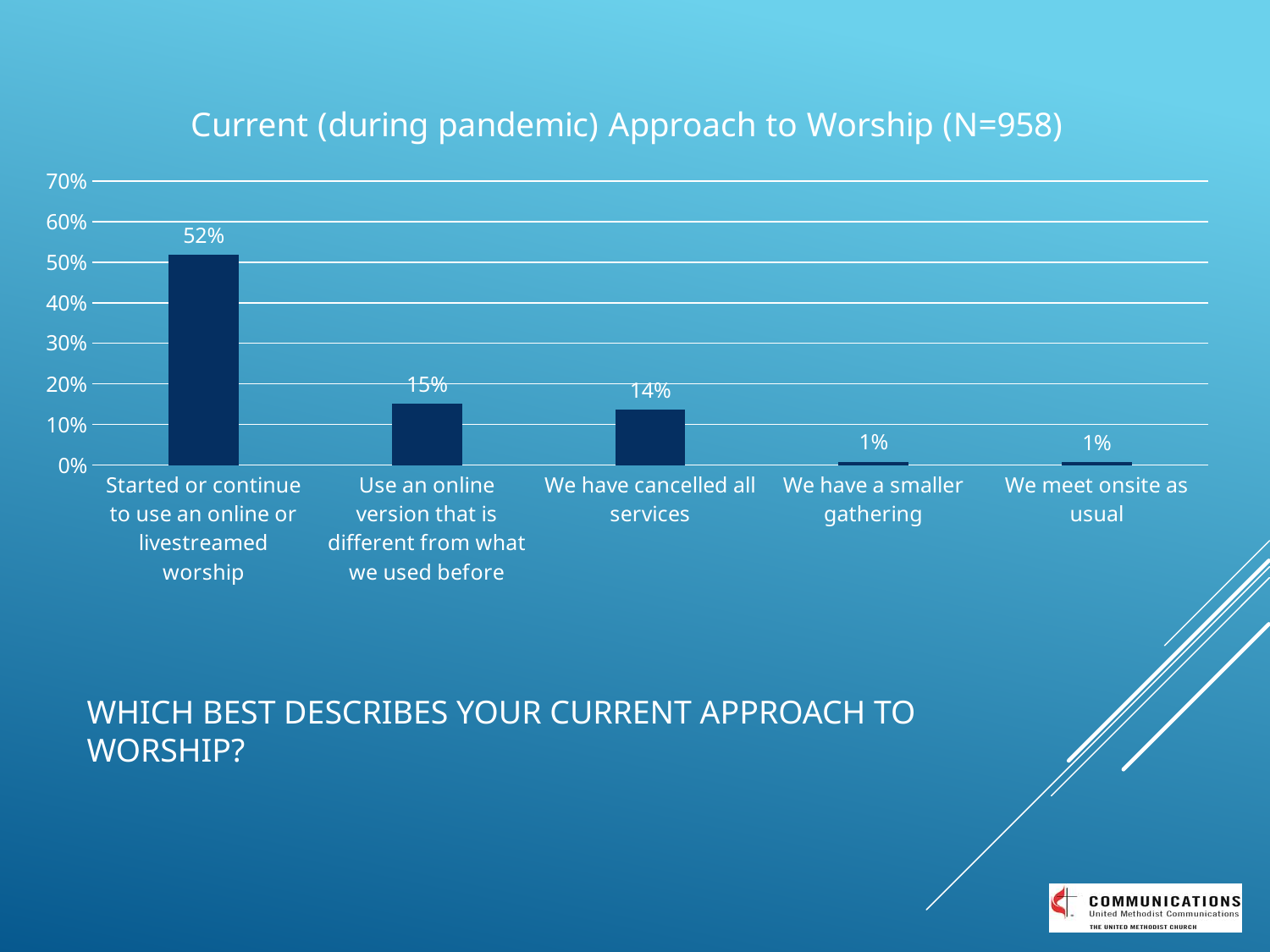
What is the title of the chart? Current (during pandemic) Approach to Worship (N=958) What percentage of respondents use an online version that is different from what they used before? 15% What percentage of respondents have cancelled all services? 14% How many categories are shown on the chart? 5 Is the value for 'Started or continue to use an online or livestreamed worship' greater or less than 40%? greater Which approach to worship has the highest percentage? Started or continue to use an online or livestreamed worship Which is larger: the percentage for 'We have cancelled all services' or for 'We have a smaller gathering'? We have cancelled all services What is the difference in percentage points between 'Use an online version that is different from what we used before' and 'We have cancelled all services'? 1% What percentage of respondents meet onsite as usual? 1% What percentage of respondents started or continue to use an online or livestreamed worship? 52% What kind of chart is shown on the slide? Bar chart What is the difference in percentage points between 'Started or continue to use an online or livestreamed worship' and 'We have cancelled all services'? 38%